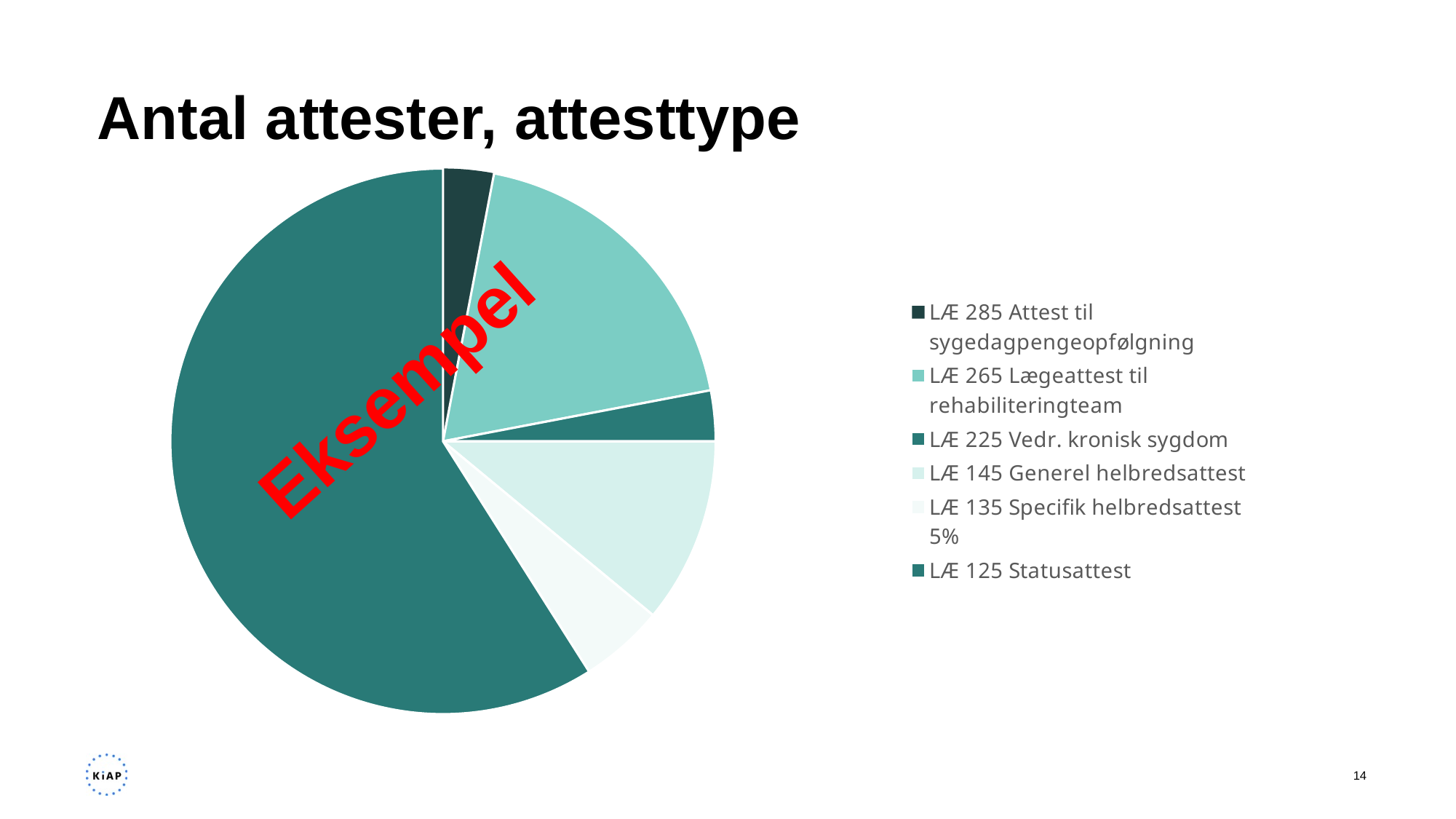
What red watermark text is written across the pie chart? Eksempel How many entries does the legend list? 6 How many slices does the pie chart have? 6 What is the title of the chart? Antal attester, attesttype Does the LÆ 125 Statusattest slice take up more or less than half of the pie? more than half Which slice is larger: LÆ 125 Statusattest or LÆ 265 Lægeattest til rehabiliteringteam? LÆ 125 Statusattest What kind of chart is shown on the slide? pie chart Which attest type has the largest slice of the pie? LÆ 125 Statusattest Which slice is larger: LÆ 145 Generel helbredsattest or LÆ 135 Specifik helbredsattest? LÆ 145 Generel helbredsattest Which slice is larger: LÆ 265 Lægeattest til rehabiliteringteam or LÆ 145 Generel helbredsattest? LÆ 265 Lægeattest til rehabiliteringteam